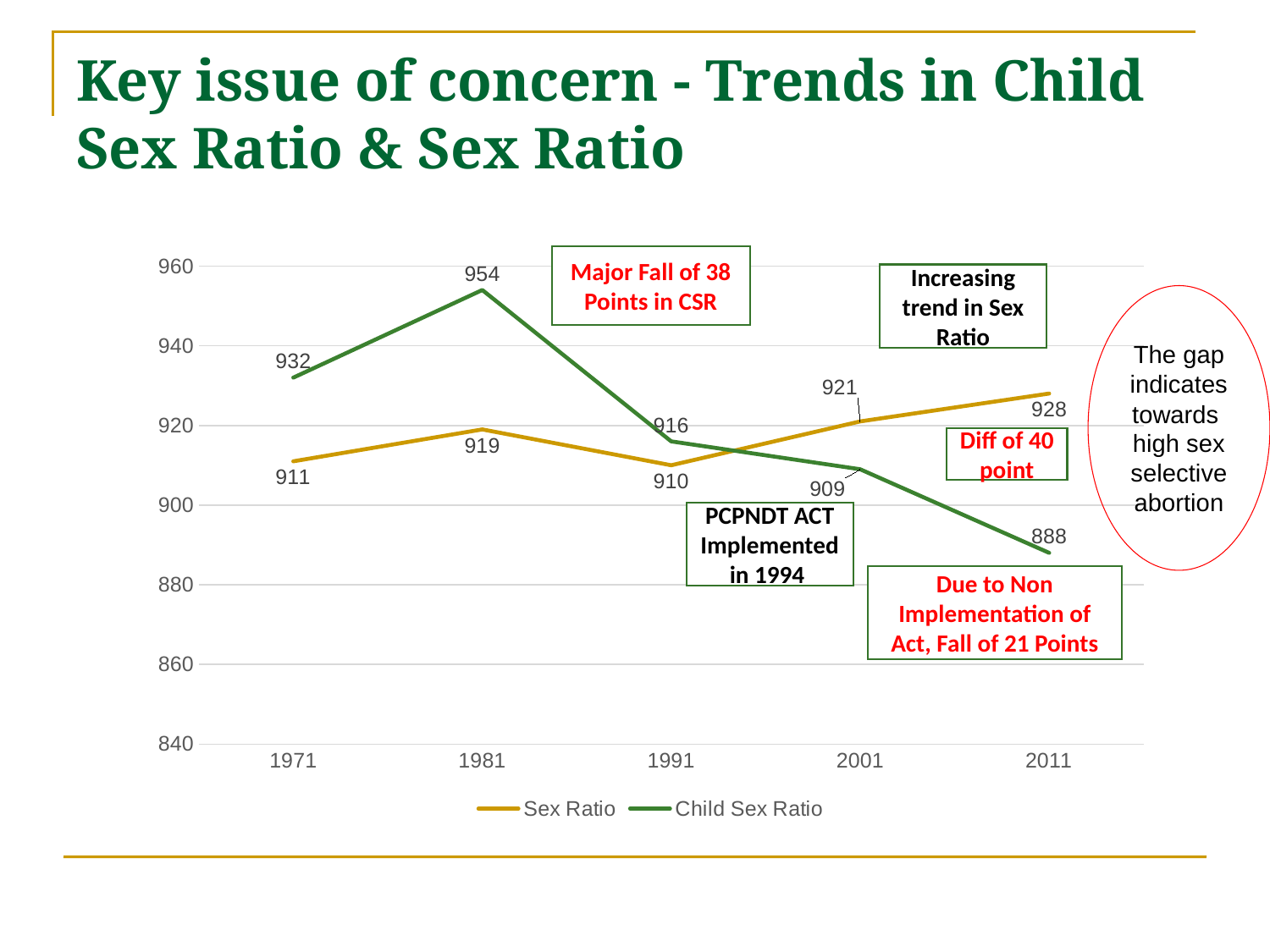
What type of chart is shown on the slide? line chart Which series is drawn in green? Child Sex Ratio Which is larger in 2011, the Sex Ratio or the Child Sex Ratio? Sex Ratio What is the difference between the Child Sex Ratio in 1981 and in 1991? 38 What is the Child Sex Ratio value for 1981? 954 What is the Child Sex Ratio value for 2011? 888 How many series does the legend list? 2 What is the Sex Ratio value for 1991? 910 In which year is the Child Sex Ratio highest? 1981 How many years are plotted on the x axis? 5 In which year is the Sex Ratio lowest? 1991 Does the Child Sex Ratio rise or fall from 1981 to 2011? fall